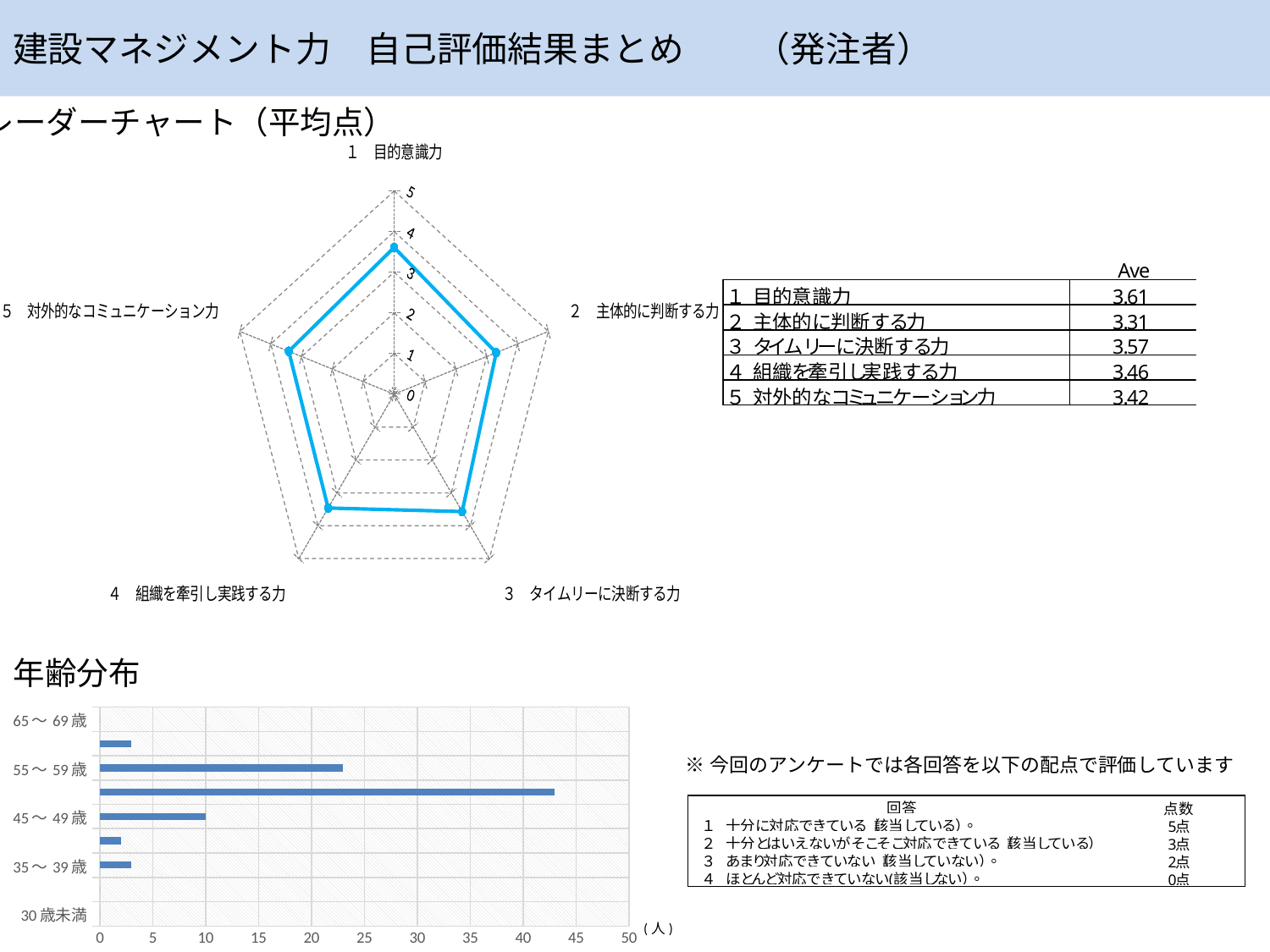
In the radar chart レーダーチャート（平均点）, what is the average score for 1 目的意識力? 3.61 How many axes (categories) does the radar chart レーダーチャート（平均点） have? 5 What kind of chart is the 年齢分布 chart at the bottom of the slide? bar chart In the radar chart レーダーチャート（平均点）, what is the maximum value shown on the radial axis? 5 In the radar chart レーダーチャート（平均点）, which category has the highest average score? 1 目的意識力 In the 年齢分布 bar chart, what is the value for 45～49歳? 10 In the radar chart レーダーチャート（平均点）, which category has the lowest average score? 2 主体的に判断する力 In the radar chart レーダーチャート（平均点）, what is the average score for 2 主体的に判断する力? 3.31 In the radar chart レーダーチャート（平均点）, what is the difference between the scores for 3 タイムリーに決断する力 and 4 組織を牽引し実践する力? 0.11 In the 年齢分布 bar chart, is the value for 55～59歳 greater or less than 20? greater What kind of chart is the レーダーチャート（平均点） chart at the top of the slide? radar chart In the 年齢分布 bar chart, which is larger, the value for 55～59歳 or the value for 35～39歳? 55～59歳